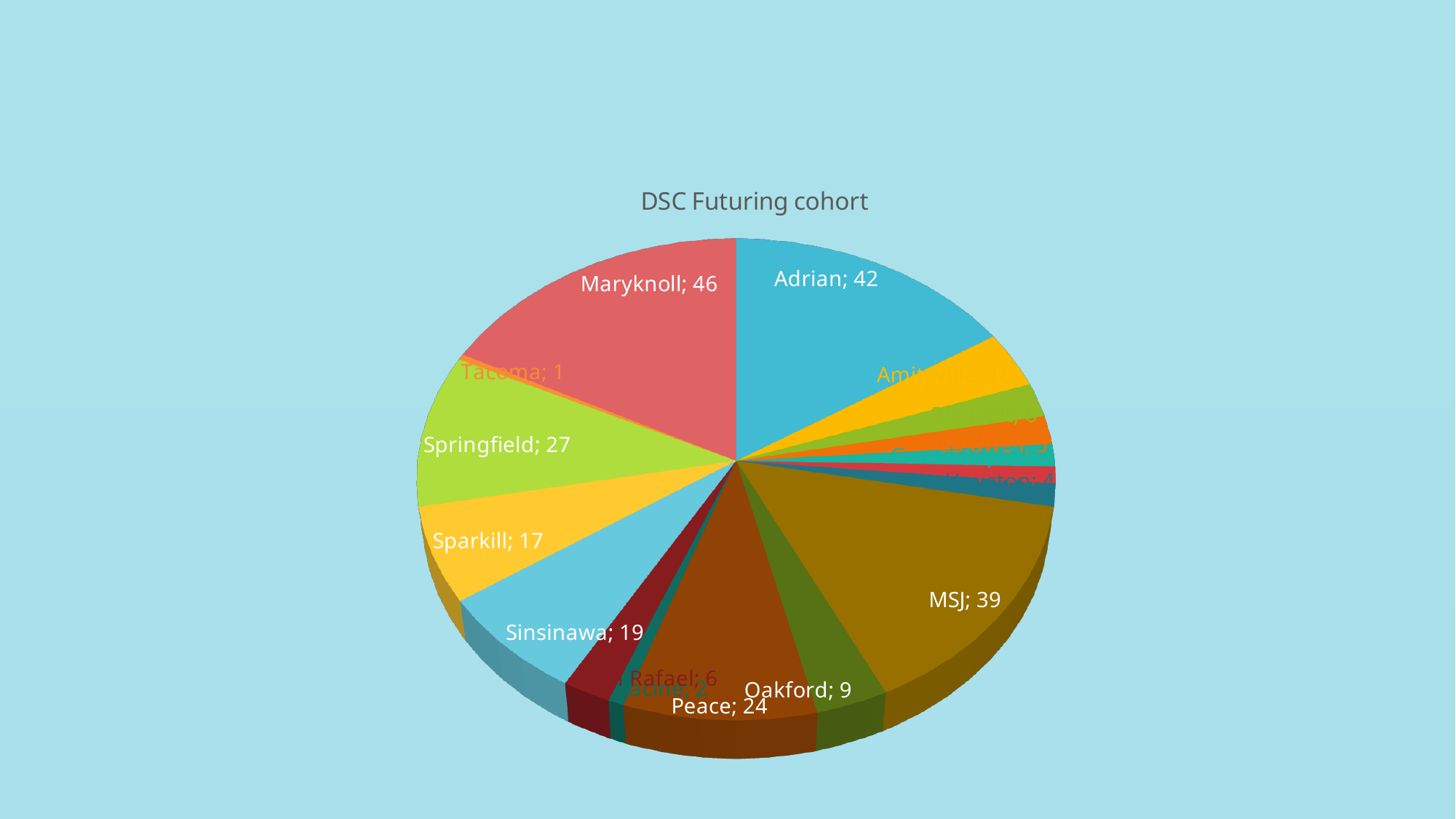
Which category has the largest slice of the pie? Maryknoll What is the value for Maryknoll? 46 What is the title of the chart? DSC Futuring cohort What is the value for Oakford? 9 What is the value for Springfield? 27 What is the difference between the values for Maryknoll and Adrian? 4 What is the value for Peace? 24 What is the value for Adrian? 42 What is the difference between the values for Sinsinawa and Sparkill? 2 Which is larger, the value for Adrian or the value for MSJ? Adrian What is the value for MSJ? 39 What type of chart is shown on the slide? pie chart